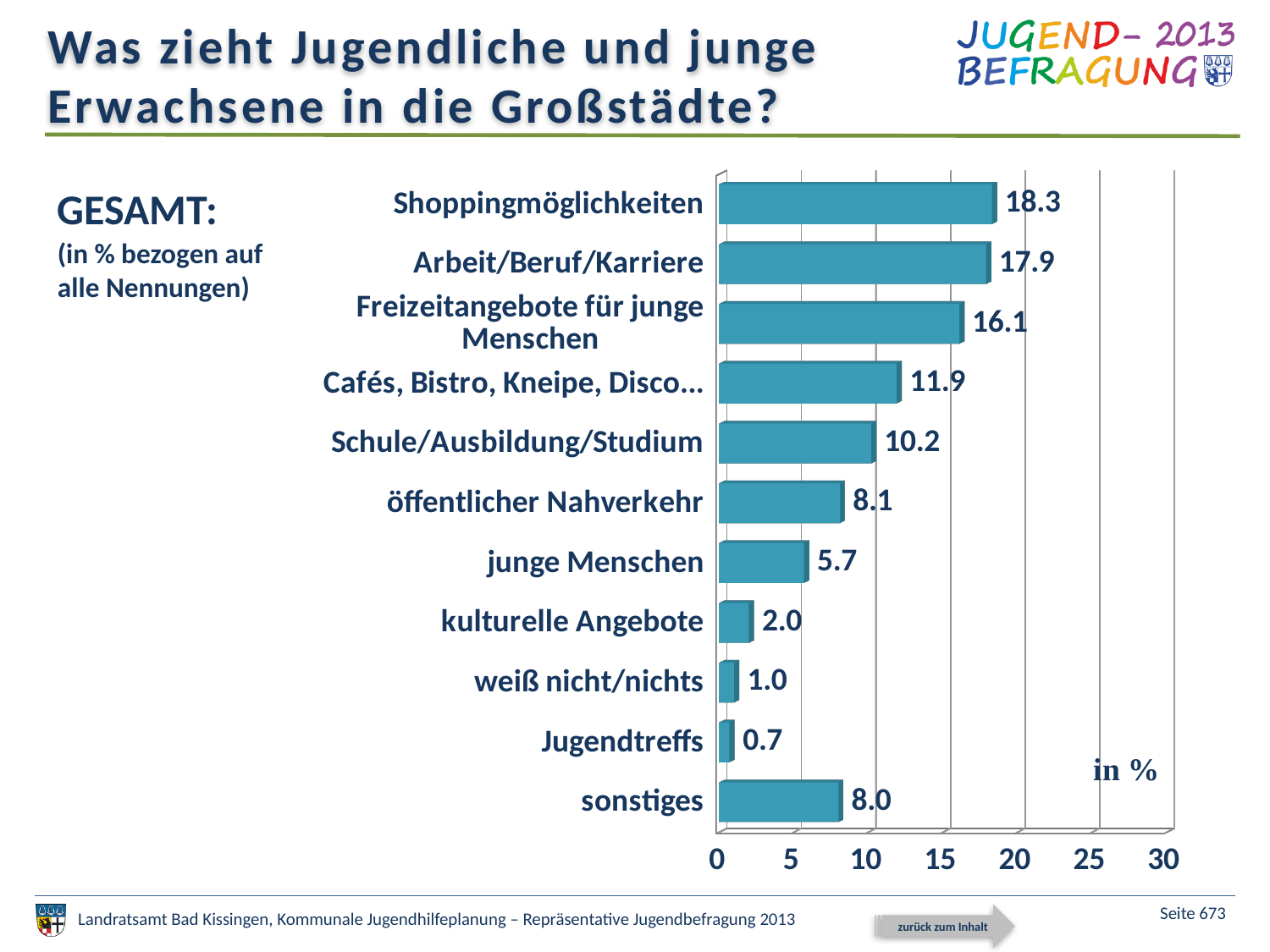
What is the value for Shoppingmöglichkeiten? 18.3 Which is larger, the value for Cafés, Bistro, Kneipe, Disco... or the value for Schule/Ausbildung/Studium? Cafés, Bistro, Kneipe, Disco... Which category has the highest value? Shoppingmöglichkeiten What is the difference between the values for Shoppingmöglichkeiten and Arbeit/Beruf/Karriere? 0.4 What is the highest tick value shown on the horizontal axis? 30 Which category has the lowest value? Jugendtreffs What is the difference between the values for öffentlicher Nahverkehr and junge Menschen? 2.4 What kind of chart is shown on the slide? bar chart Is the value for Freizeitangebote für junge Menschen greater or less than 15? greater What is the value for Schule/Ausbildung/Studium? 10.2 What is the value for sonstiges? 8.0 How many categories are shown in the chart? 11